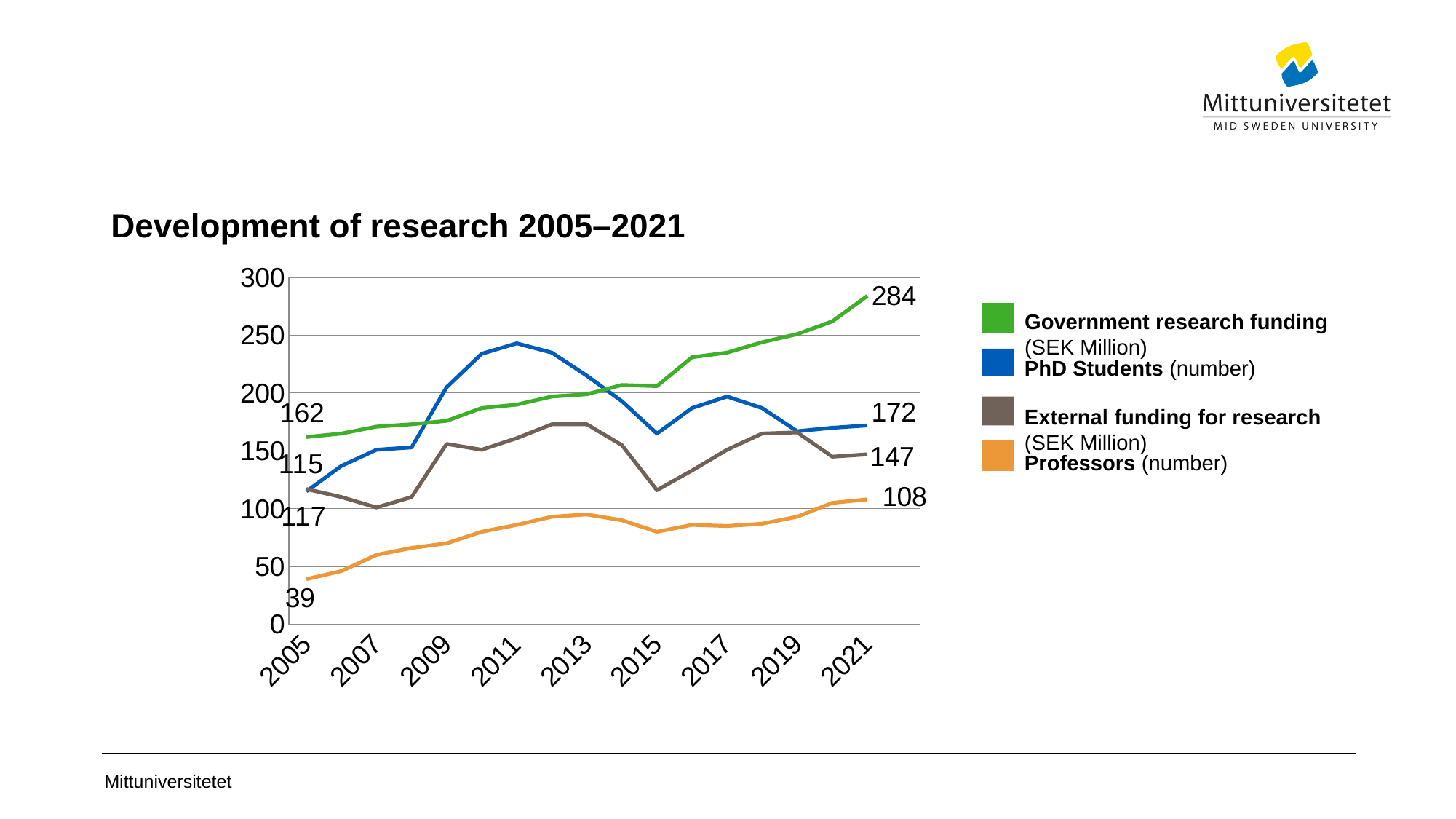
What is the value of Government research funding (SEK Million) in 2021? 284 By how much did Government research funding increase from 2005 to 2021? 122 What is the value of External funding for research (SEK Million) in 2021? 147 What is the number of Professors in 2005? 39 What is the number of Professors in 2021? 108 What kind of chart is shown on the slide? line chart What is the number of PhD Students in 2021? 172 How many series does the legend list? 4 What is the value of Government research funding (SEK Million) in 2005? 162 Is the number of PhD Students in 2011 greater or less than 200? greater Which series has the highest value in 2021? Government research funding Does the Government research funding line generally rise or fall from 2005 to 2021? rise